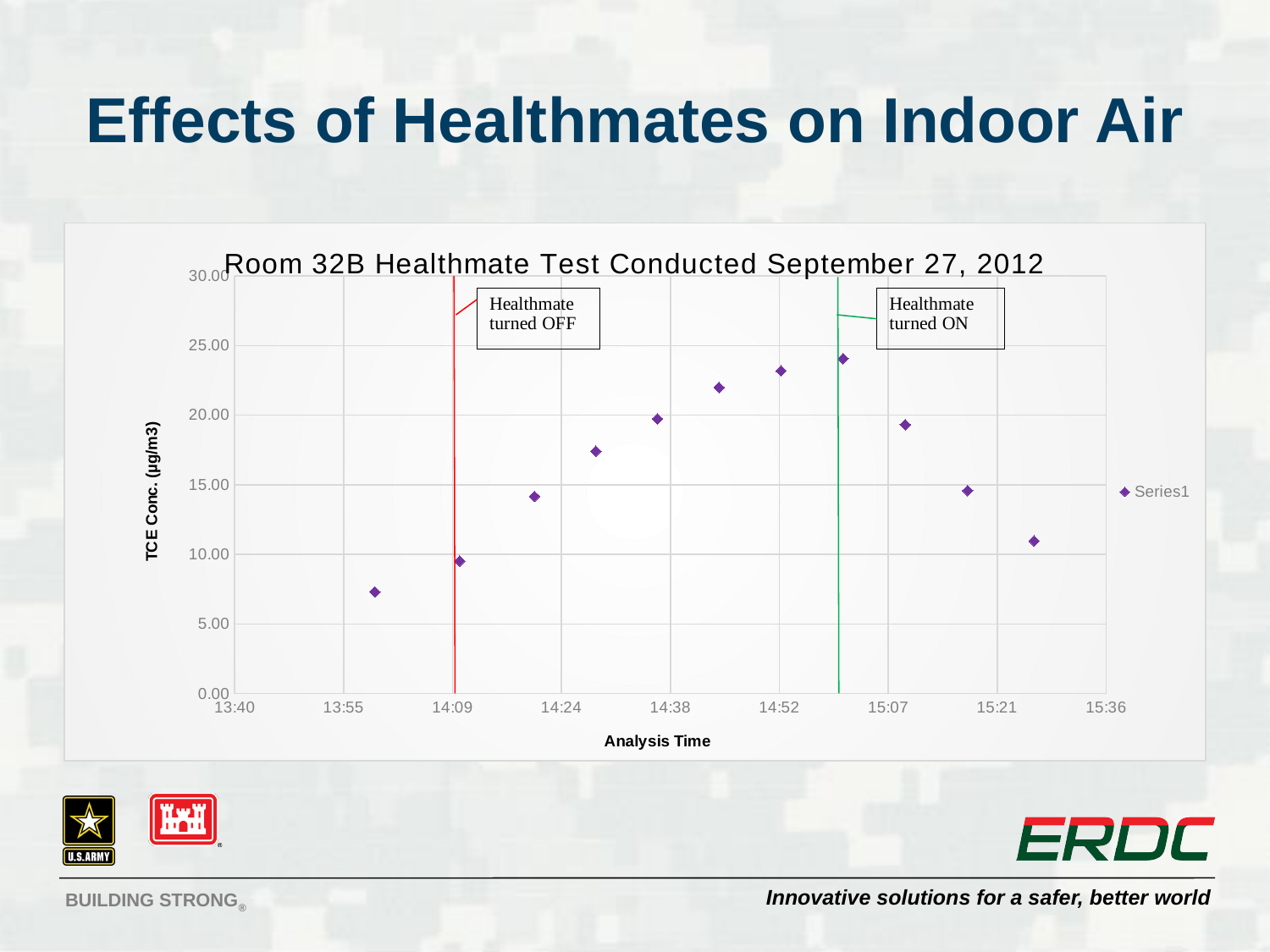
Do the TCE concentration values rise or fall between the 'Healthmate turned OFF' line and the 'Healthmate turned ON' line? rise What kind of chart is shown on the slide? scatter chart Is the highest plotted TCE concentration greater or less than 20.00? greater Is the highest plotted TCE concentration greater or less than 25.00? less What is the title of the chart? Room 32B Healthmate Test Conducted September 27, 2012 What is the name of the series shown in the legend? Series1 Is the last plotted point (after 15:21) greater or less than 15.00? less Do the TCE concentration values rise or fall after the 'Healthmate turned ON' line? fall How many series does the legend list? 1 Which is larger: the TCE concentration at the point near 14:52 or the point near 15:21? the point near 14:52 How many data points are plotted on the chart? 11